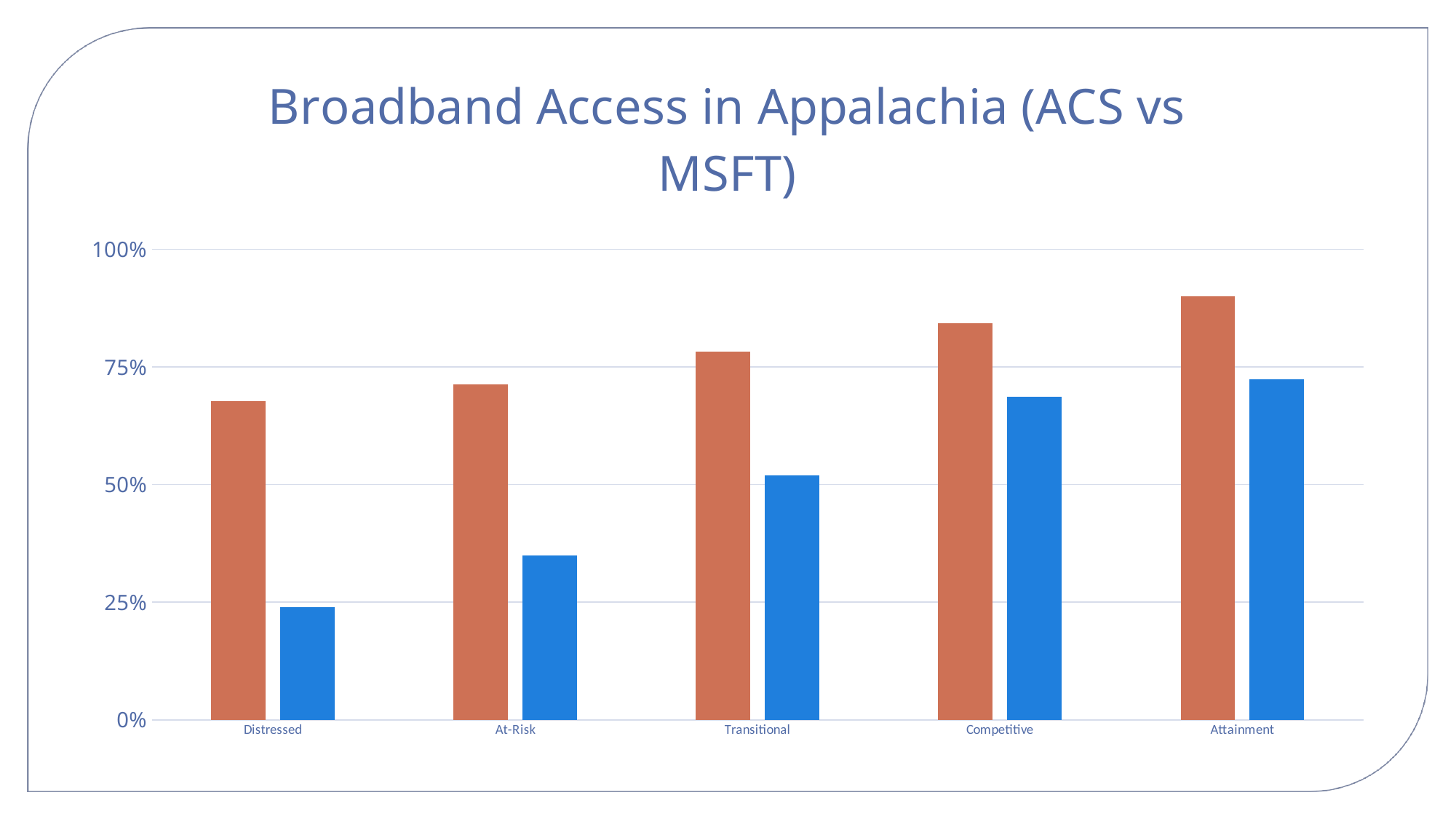
What is the title of the chart? Broadband Access in Appalachia (ACS vs MSFT) In the Distressed category, which bar is larger, the orange bar or the blue bar? Orange Which category has the lowest blue bar? Distressed How many categories are shown on the x axis of the chart? 5 Is the blue bar for Competitive greater or less than 50%? greater Is the blue bar for At-Risk greater or less than 25%? greater Is the orange bar for Distressed greater or less than 50%? greater Do the orange bars rise or fall from Distressed to Attainment along the x axis? Rise What type of chart is shown on the slide? Bar chart Which category has the lowest orange bar? Distressed Which category has the highest orange bar? Attainment